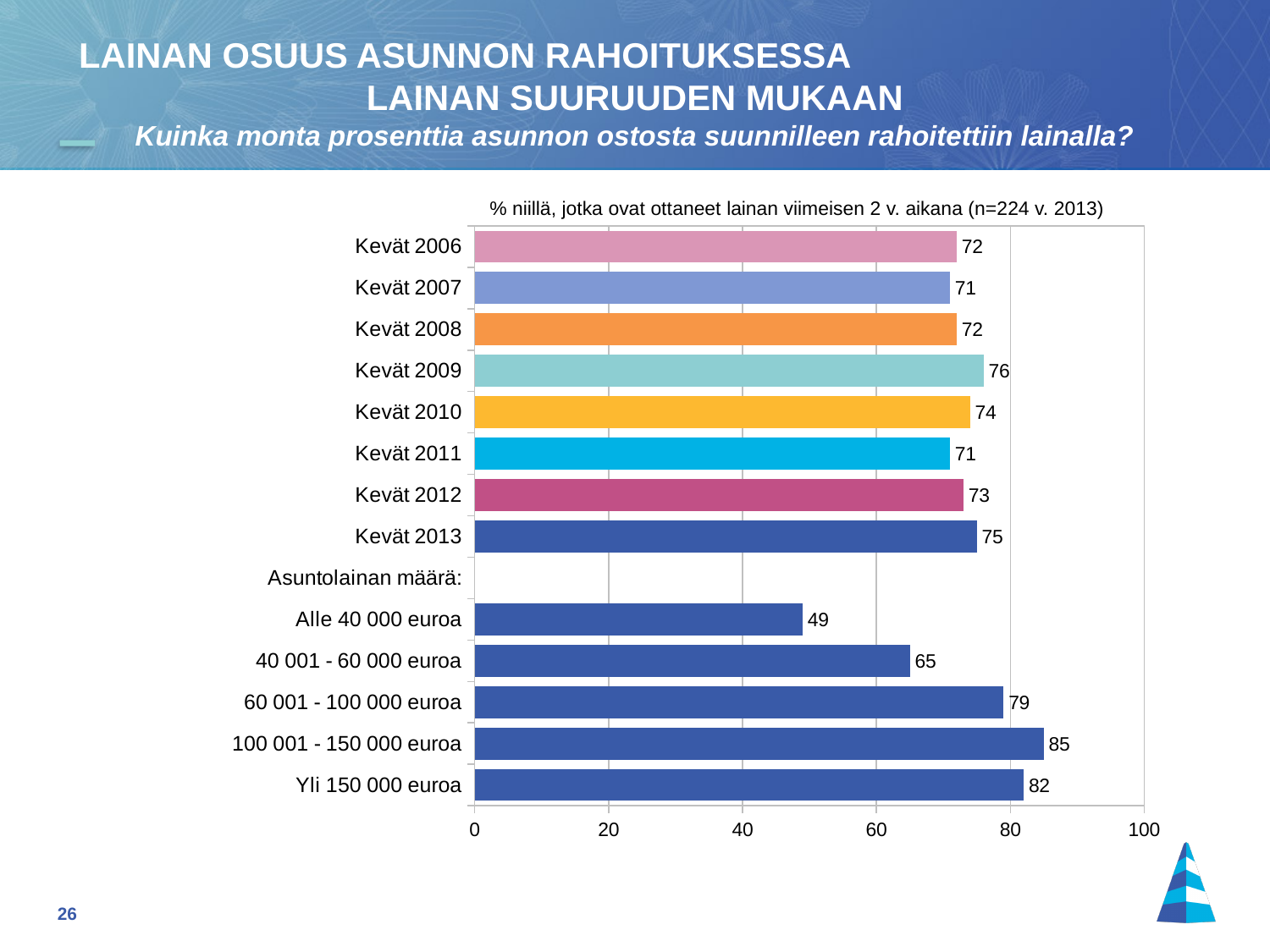
What is the difference between the values for Kevät 2013 and Kevät 2006? 3 What is the difference between the values for Yli 150 000 euroa and 40 001 - 60 000 euroa? 17 What kind of chart is shown on the slide? bar chart Which is larger, the value for 60 001 - 100 000 euroa or the value for Yli 150 000 euroa? Yli 150 000 euroa What is the value for Alle 40 000 euroa? 49 Among the Kevät years, which has the highest value? Kevät 2009 Which category has the highest value? 100 001 - 150 000 euroa What is the value for Kevät 2013? 75 Which category has the lowest value? Alle 40 000 euroa What is the value for 100 001 - 150 000 euroa? 85 Is the value for Kevät 2010 greater or less than 60? greater What is the subtitle text printed above the chart? % niillä, jotka ovat ottaneet lainan viimeisen 2 v. aikana (n=224 v. 2013)